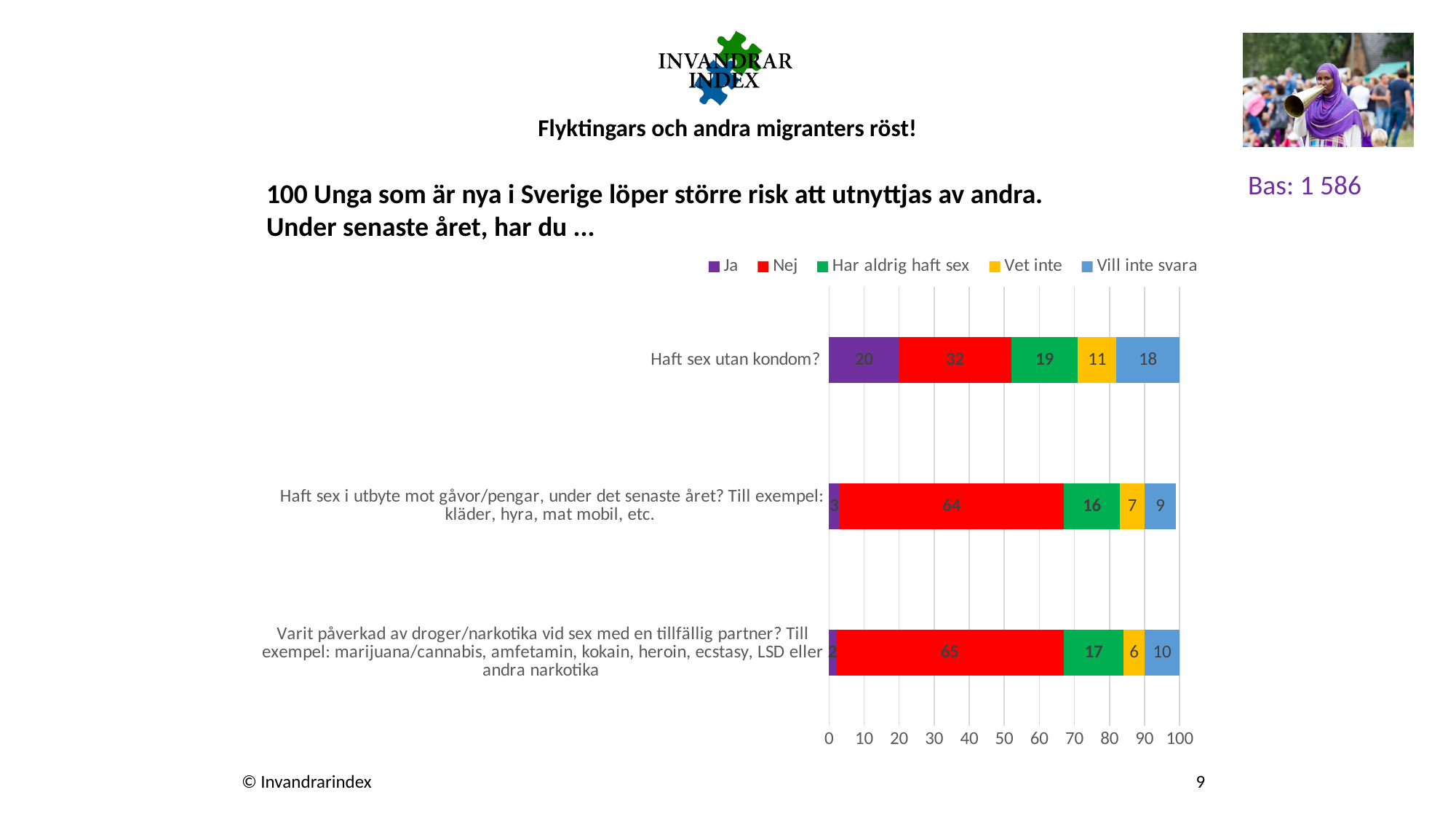
What is the value for "Nej" in the "Haft sex i utbyte mot gåvor/pengar" bar? 64 What is the value for "Ja" in the "Haft sex utan kondom?" bar? 20 What is the difference between the "Nej" value and the "Ja" value in the "Haft sex utan kondom?" bar? 12 What is the total of the stacked bar for "Haft sex i utbyte mot gåvor/pengar"? 99 Which category has the lowest value for "Nej"? Haft sex utan kondom? What kind of chart is shown on the slide? Stacked bar chart Which is larger: the "Vill inte svara" value for "Haft sex utan kondom?" or for "Haft sex i utbyte mot gåvor/pengar"? Haft sex utan kondom? How many categories (bars) are shown in the chart? 3 How many series does the legend list? 5 Which legend entry is shown in red? Nej What is the value for "Vet inte" in the "Varit påverkad av droger/narkotika vid sex med en tillfällig partner?" bar? 6 Which category has the highest value for "Ja"? Haft sex utan kondom?